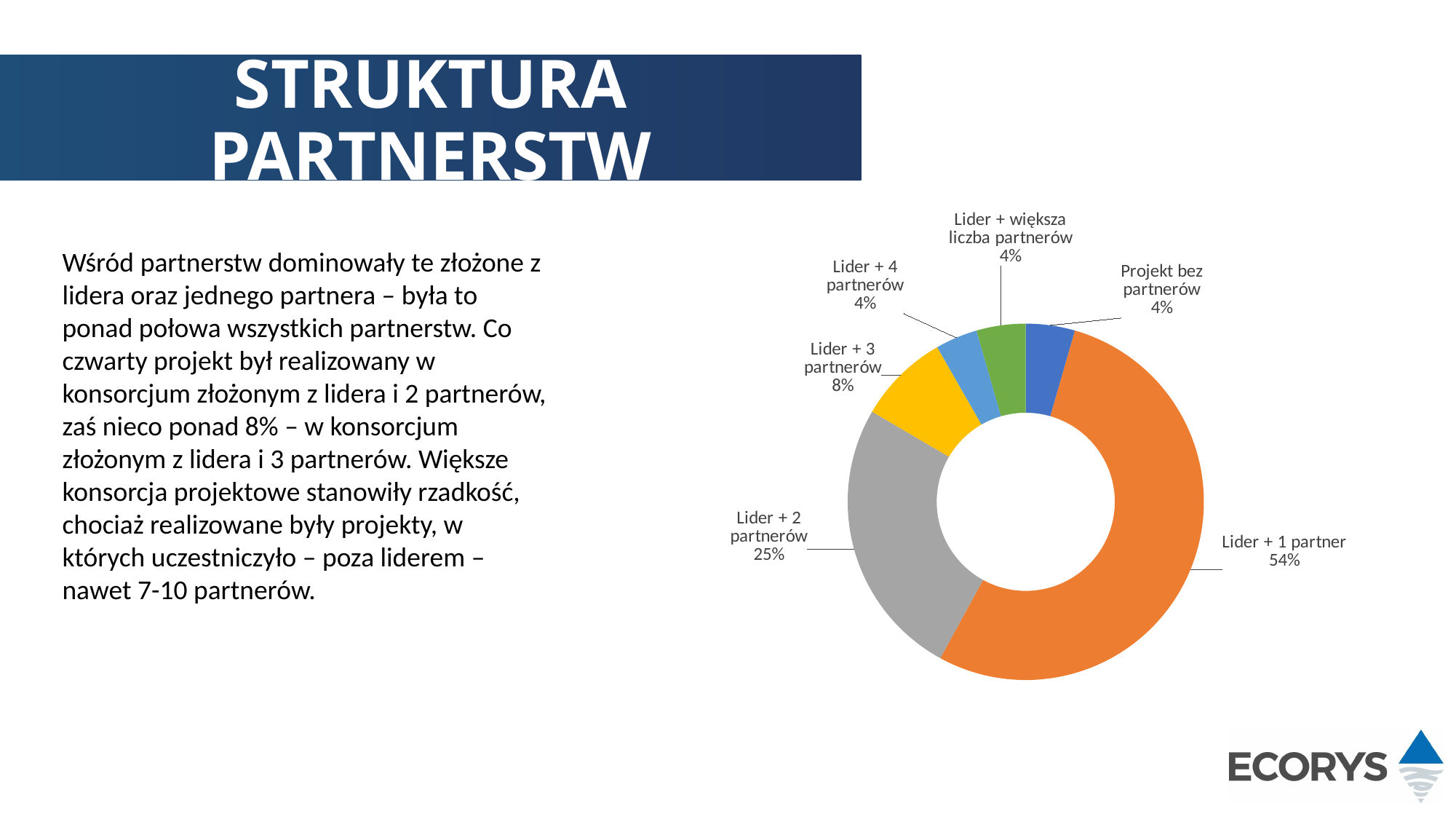
What share of the chart does "Lider + 2 partnerów" represent? 25% What share of the chart does "Projekt bez partnerów" represent? 4% What share of the chart does "Lider + 3 partnerów" represent? 8% What is the difference in percentage points between "Lider + 1 partner" and "Lider + 2 partnerów"? 29 How many categories in the chart have a share of 4%? 3 What kind of chart is shown on the slide? Doughnut chart Which category has the largest share of the chart? Lider + 1 partner How many categories are shown in the chart? 6 What is the difference in percentage points between "Lider + 2 partnerów" and "Lider + 3 partnerów"? 17 Which is larger, the share for "Lider + 3 partnerów" or the share for "Lider + 4 partnerów"? Lider + 3 partnerów What colour is the slice for "Lider + 2 partnerów"? Grey What share of the chart does "Lider + 1 partner" represent? 54%